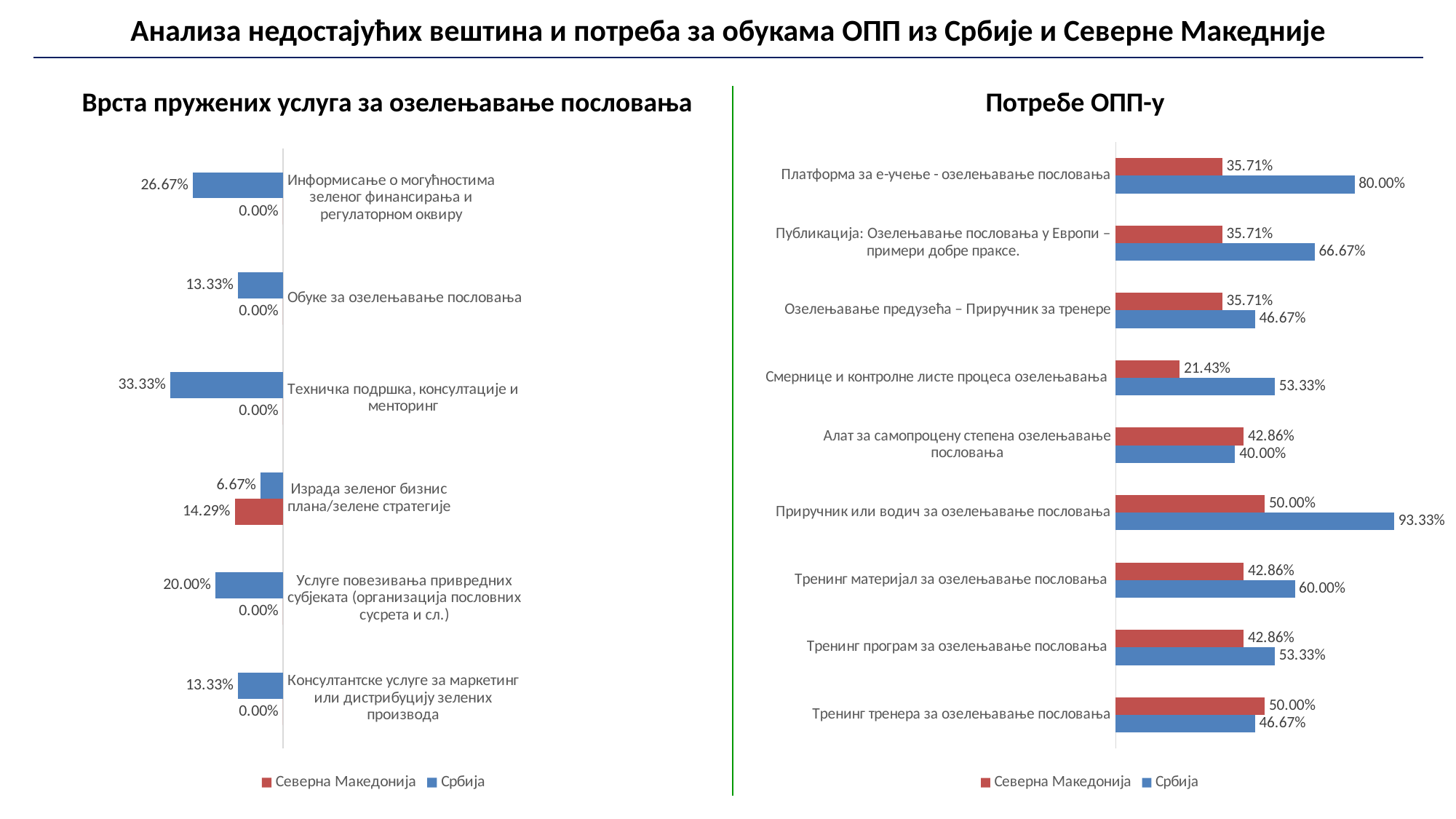
In the chart "Потребе ОПП-у", which series has the larger value for "Тренинг тренера за озелењавање пословања"? Северна Македонија In the chart "Потребе ОПП-у", what is the value for Северна Македонија for "Смернице и контролне листе процеса озелењавања"? 21.43% In the chart "Врста пружених услуга за озелењавање пословања", which category has the lowest value for Србија? Израда зеленог бизнис плана/зелене стратегије In the chart "Врста пружених услуга за озелењавање пословања", what is the value for Северна Македонија for "Израда зеленог бизнис плана/зелене стратегије"? 14.29% In the chart "Потребе ОПП-у", what is the value for Србија for "Приручник или водич за озелењавање пословања"? 93.33% How many categories are shown in the chart "Потребе ОПП-у"? 9 How many series does the legend of the chart "Потребе ОПП-у" list? 2 What kind of chart is "Врста пружених услуга за озелењавање пословања"? Bar chart In the chart "Врста пружених услуга за озелењавање пословања", what is the value for Србија for "Техничка подршка, консултације и менторинг"? 33.33% How many categories are shown in the chart "Врста пружених услуга за озелењавање пословања"? 6 In the chart "Потребе ОПП-у", what is the difference between the Србија and Северна Македонија values for "Платформа за е-учење - озелењавање пословања"? 44.29% In the chart "Потребе ОПП-у", which category has the highest value for Србија? Приручник или водич за озелењавање пословања